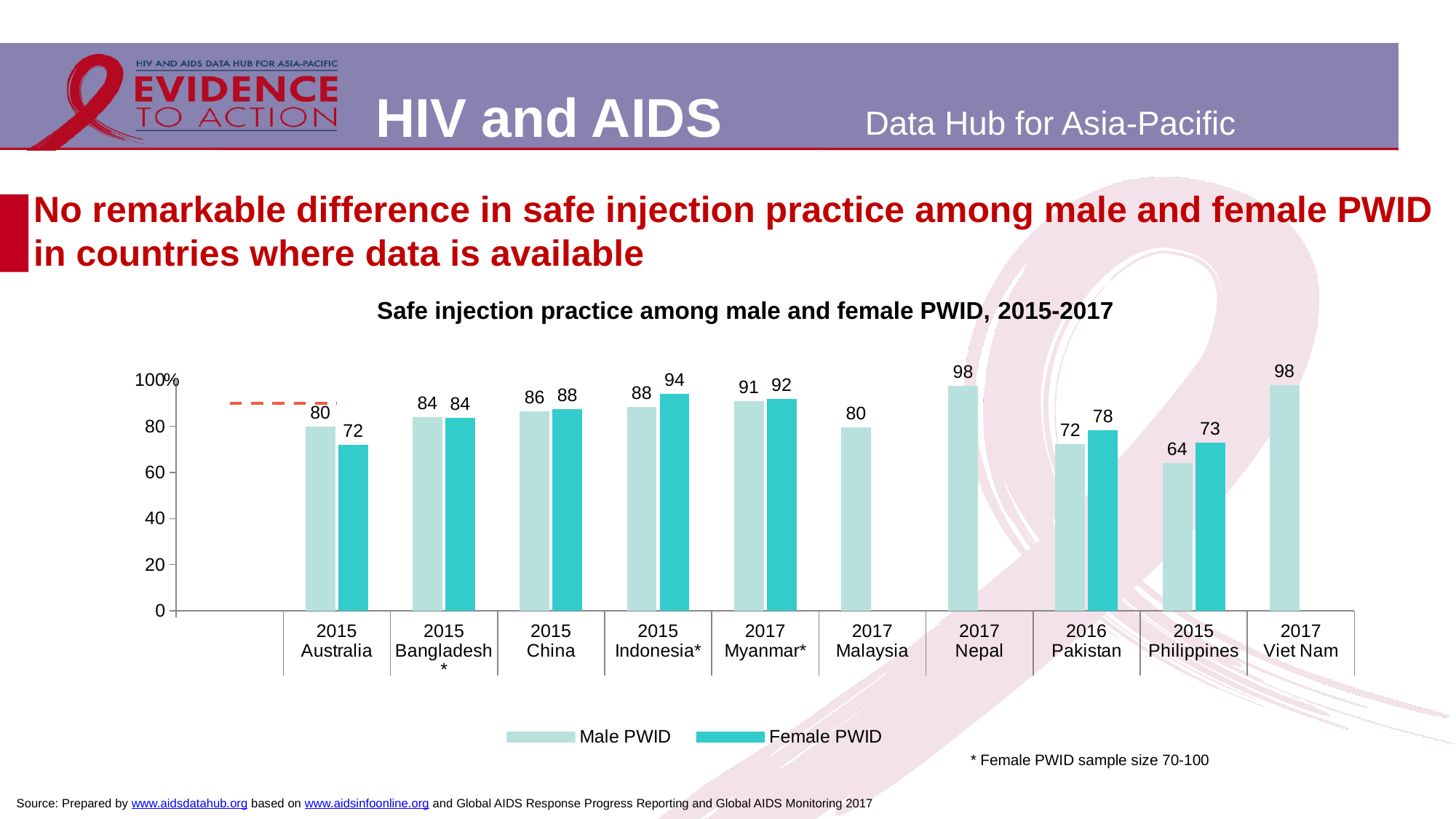
What is the Male PWID value for 2015 Australia? 80 What is the difference between the Female PWID and Male PWID values for 2015 Philippines? 9 How many series does the legend list? 2 Which country has the highest Female PWID value? 2015 Indonesia* Is the Male PWID value for 2017 Nepal greater or less than 80? greater Which country has the lowest Female PWID value? 2015 Australia Which is larger for 2016 Pakistan, the Male PWID value or the Female PWID value? Female PWID What kind of chart is shown on the slide? Bar chart What is the Male PWID value for 2015 Philippines? 64 Which country has the lowest Male PWID value? 2015 Philippines How many countries are shown on the x axis? 10 What is the Female PWID value for 2015 Indonesia*? 94